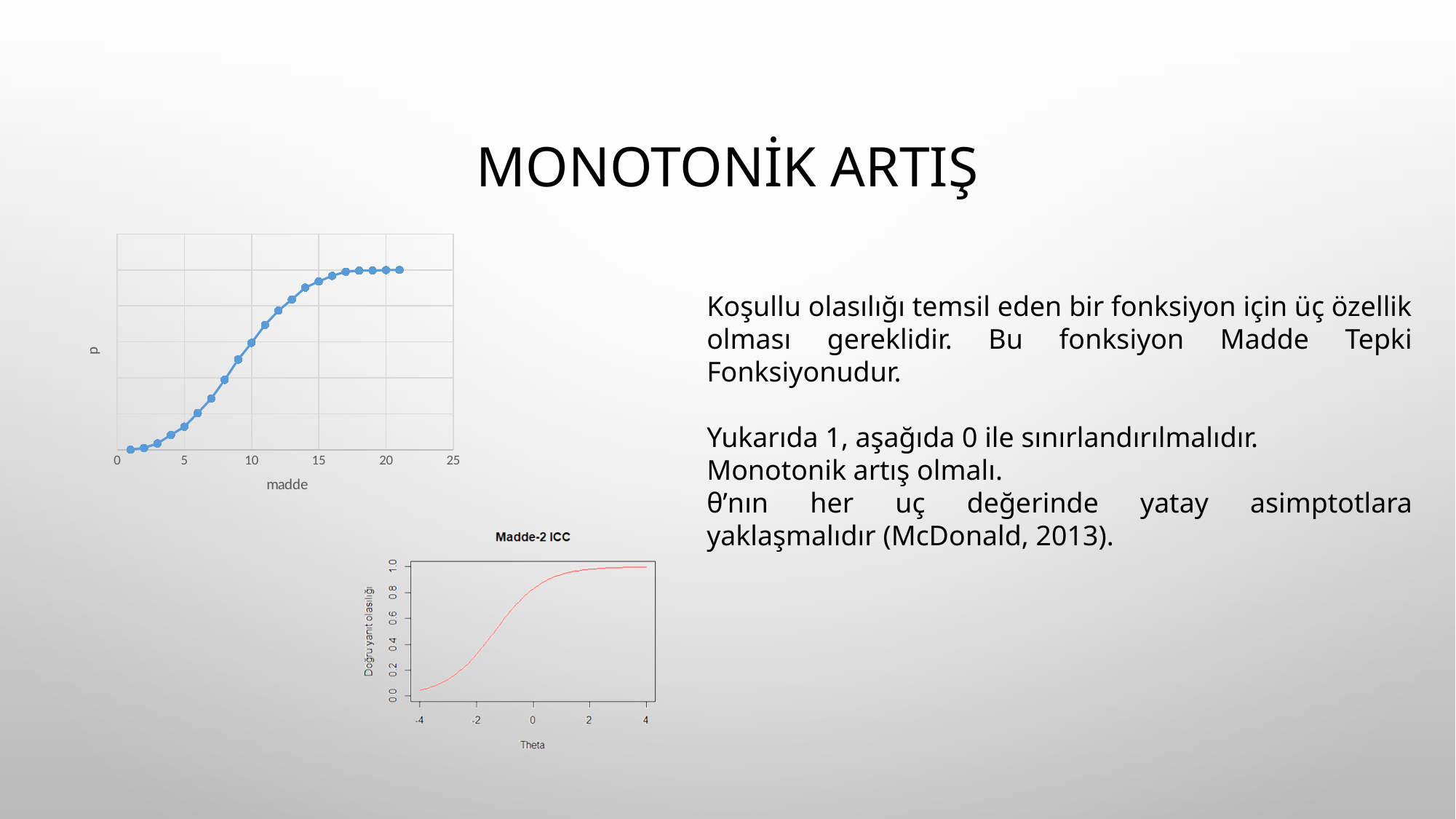
How many data points are plotted in the top-left chart (x axis 'madde')? 21 In the top-left chart (x axis 'madde'), which is larger: the value at madde 20 or the value at madde 5? madde 20 In the 'Madde-2 ICC' chart, is the value at Theta 0 greater or less than 0.8? greater In the 'Madde-2 ICC' chart, is the value at Theta 2 greater or less than 0.8? greater What is the title of the bottom chart? Madde-2 ICC In the 'Madde-2 ICC' chart, is the value at Theta -2 greater or less than 0.4? less In the 'Madde-2 ICC' chart, does the curve rise or fall as Theta increases? rise What is the x axis label of the 'Madde-2 ICC' chart? Theta What kind of chart is the top-left chart with the x axis labelled 'madde'? line chart In the top-left chart (x axis 'madde'), at which madde value is the plotted value lowest? 1 In the top-left chart (x axis 'madde'), do the values rise or fall as madde increases? rise In the 'Madde-2 ICC' chart, which is larger: the value at Theta 2 or the value at Theta -2? Theta 2